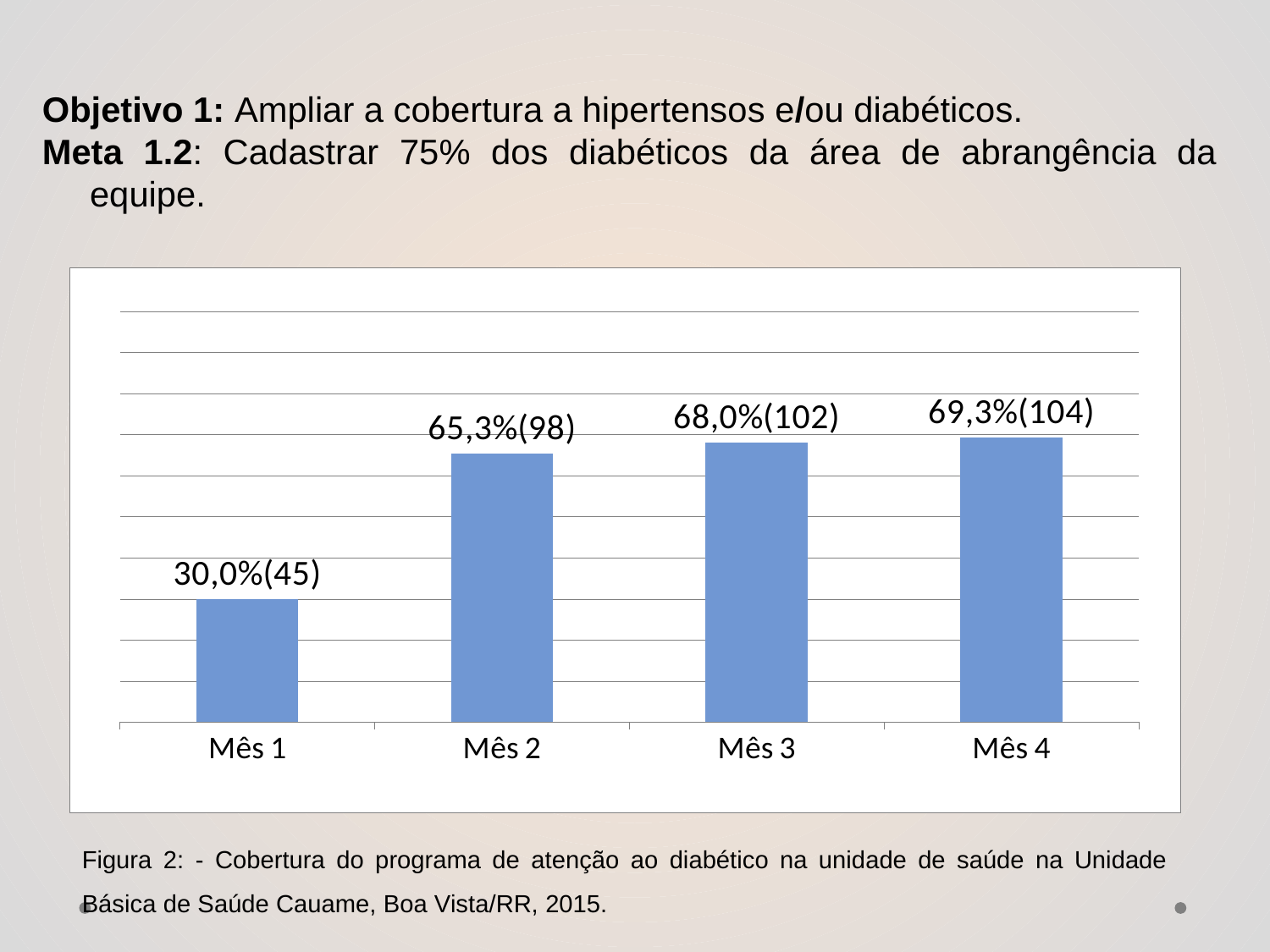
How many months are shown on the x axis? 4 What is the difference in the number of diabetics between Mês 4 and Mês 1? 59 What is the value shown for Mês 4? 69,3%(104) Which is larger, the value for Mês 1 or the value for Mês 2? Mês 2 What is the value shown for Mês 1? 30,0%(45) By how many percentage points does Mês 2 exceed Mês 1? 35,3 What percentage is shown for Mês 3? 68,0% Do the values rise or fall from Mês 1 to Mês 4? Rise What kind of chart is shown on the slide? Bar chart How many diabetics are shown in parentheses for Mês 2? 98 Which month has the highest bar? Mês 4 Which month has the lowest bar? Mês 1